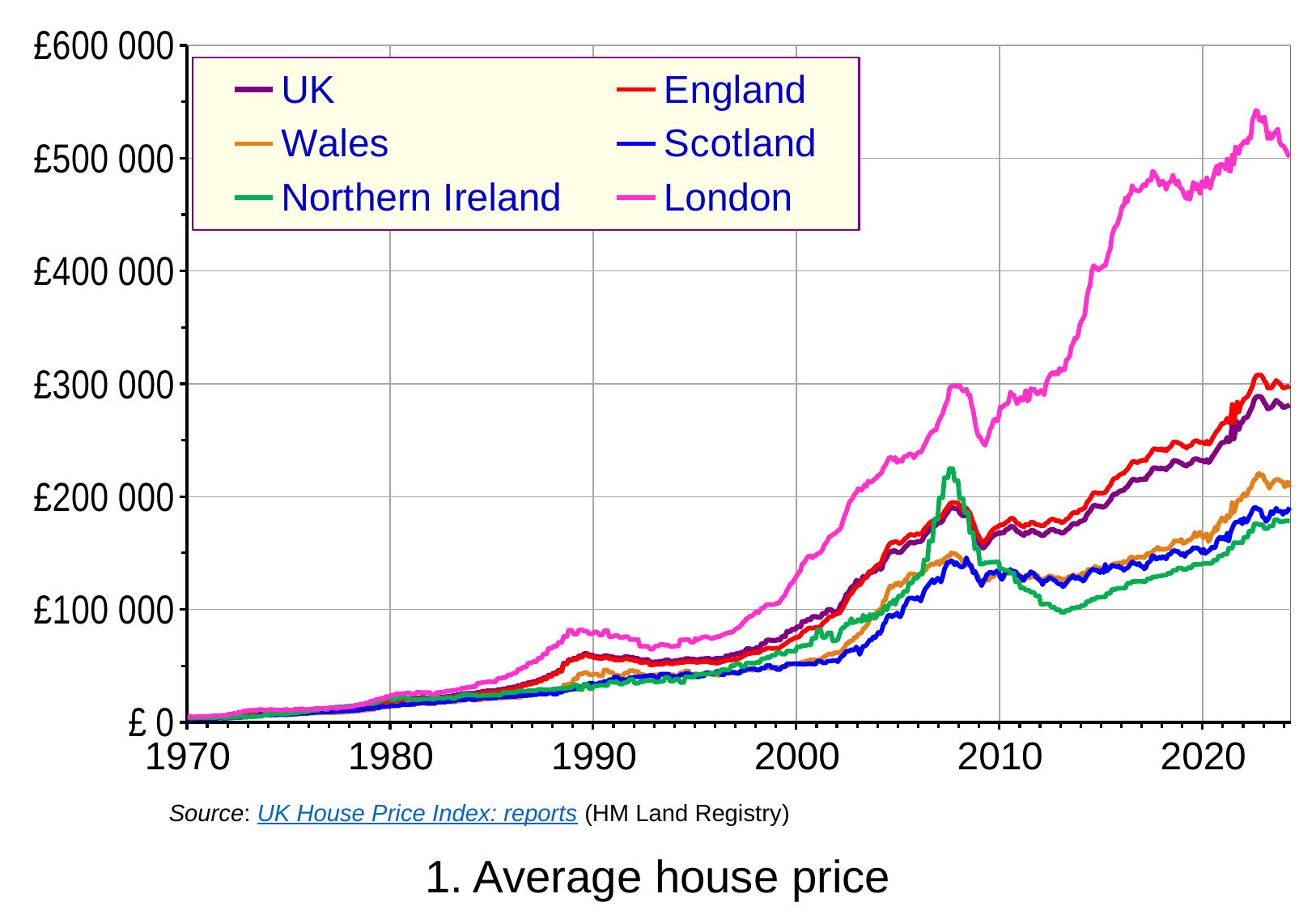
Which series reaches the highest average house price on the chart? London How many series does the legend list? 6 Which series has the lowest average house price around 2013? Northern Ireland What kind of chart is shown on the slide? line chart Is the value for Scotland in 2010 greater or less than £200 000? less Is the peak value for London greater or less than £500 000? greater Is the value for England in 2020 greater or less than £200 000? greater Which organisation is cited as the source of the data? HM Land Registry Do average house prices generally rise or fall from 1970 to the 2020s? rise What is the title of the chart? 1. Average house price In 2020, which is larger: the value for London or the value for Scotland? London